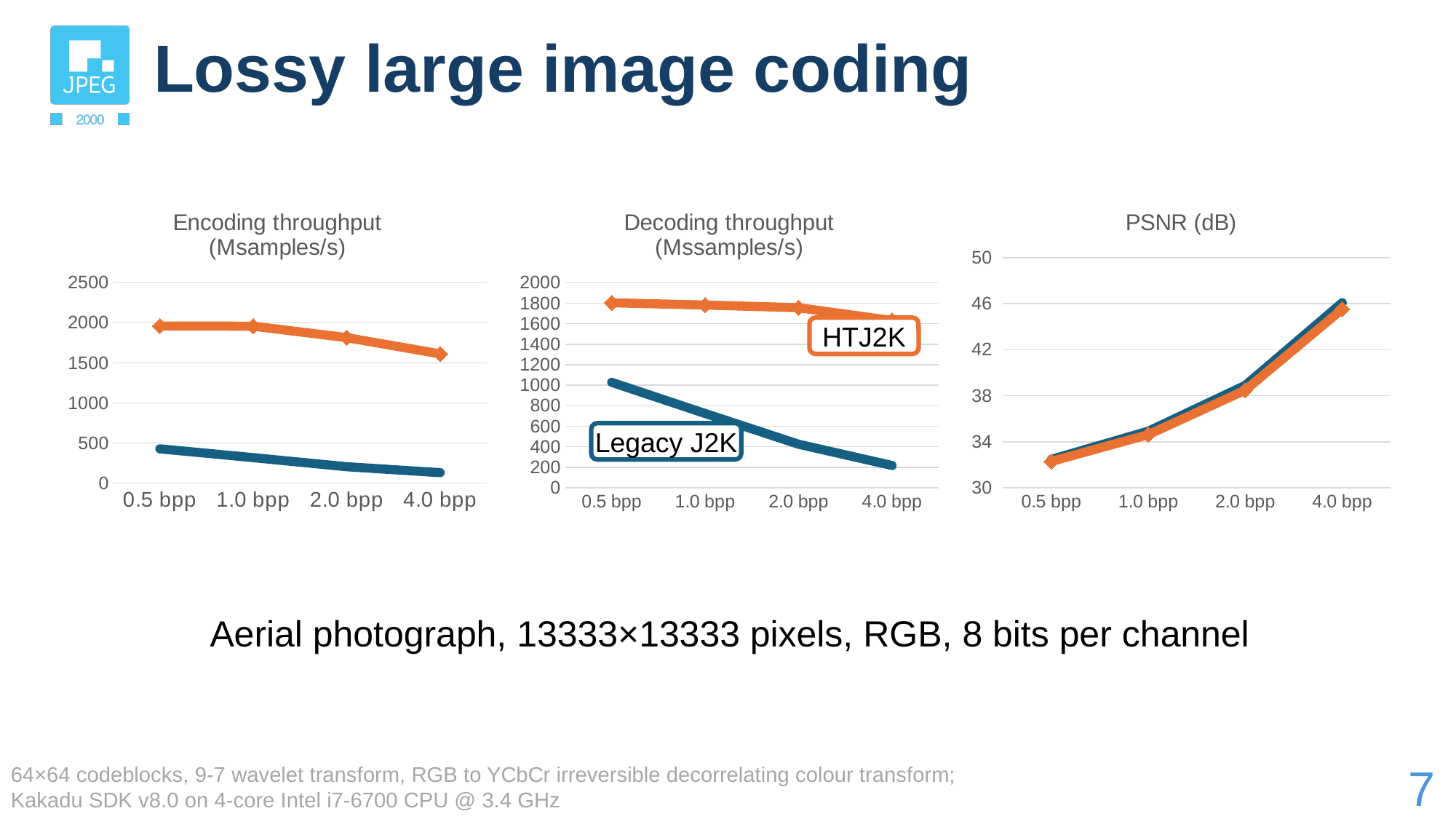
In the Decoding throughput chart, which two series are labelled? HTJ2K and Legacy J2K In the Encoding throughput chart, which series has the higher value at 2.0 bpp, HTJ2K or Legacy J2K? HTJ2K How many bit-rate points are plotted along the x axis of the Decoding throughput chart? 4 In the Decoding throughput chart, is the HTJ2K value at 0.5 bpp greater or less than 1600? greater In the Encoding throughput chart, is the Legacy J2K value at 0.5 bpp greater or less than 500? less In the Encoding throughput chart, at which bit rate is the HTJ2K throughput lowest? 4.0 bpp In the Decoding throughput chart, at which bit rate is the Legacy J2K throughput highest? 0.5 bpp In the Encoding throughput chart, is the HTJ2K value at 0.5 bpp greater or less than 1500? greater What kind of chart is the Encoding throughput chart? line chart In the PSNR (dB) chart, do the values rise or fall as the bit rate increases from 0.5 bpp to 4.0 bpp? rise